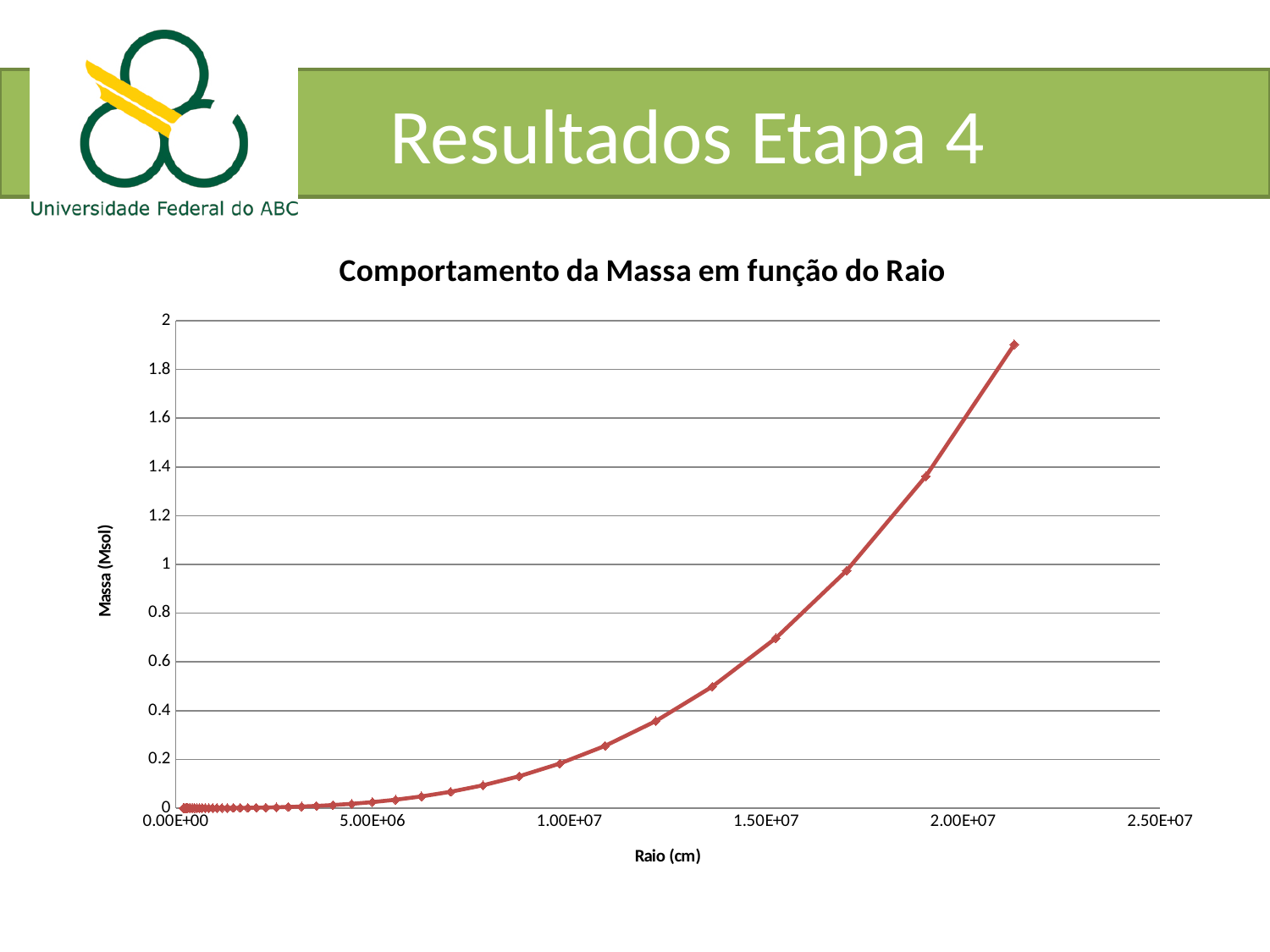
Is the value of Massa at Raio 1.50E+07 greater or less than 1? less Is the value of Massa at Raio 1.00E+07 greater or less than 0.4? less Is the highest plotted value of Massa greater or less than 1.8? greater Do the values of Massa rise or fall as Raio increases along the x axis? rise What kind of chart is shown on the slide? line chart What is the label of the x axis? Raio (cm) What is the title of the chart? Comportamento da Massa em função do Raio